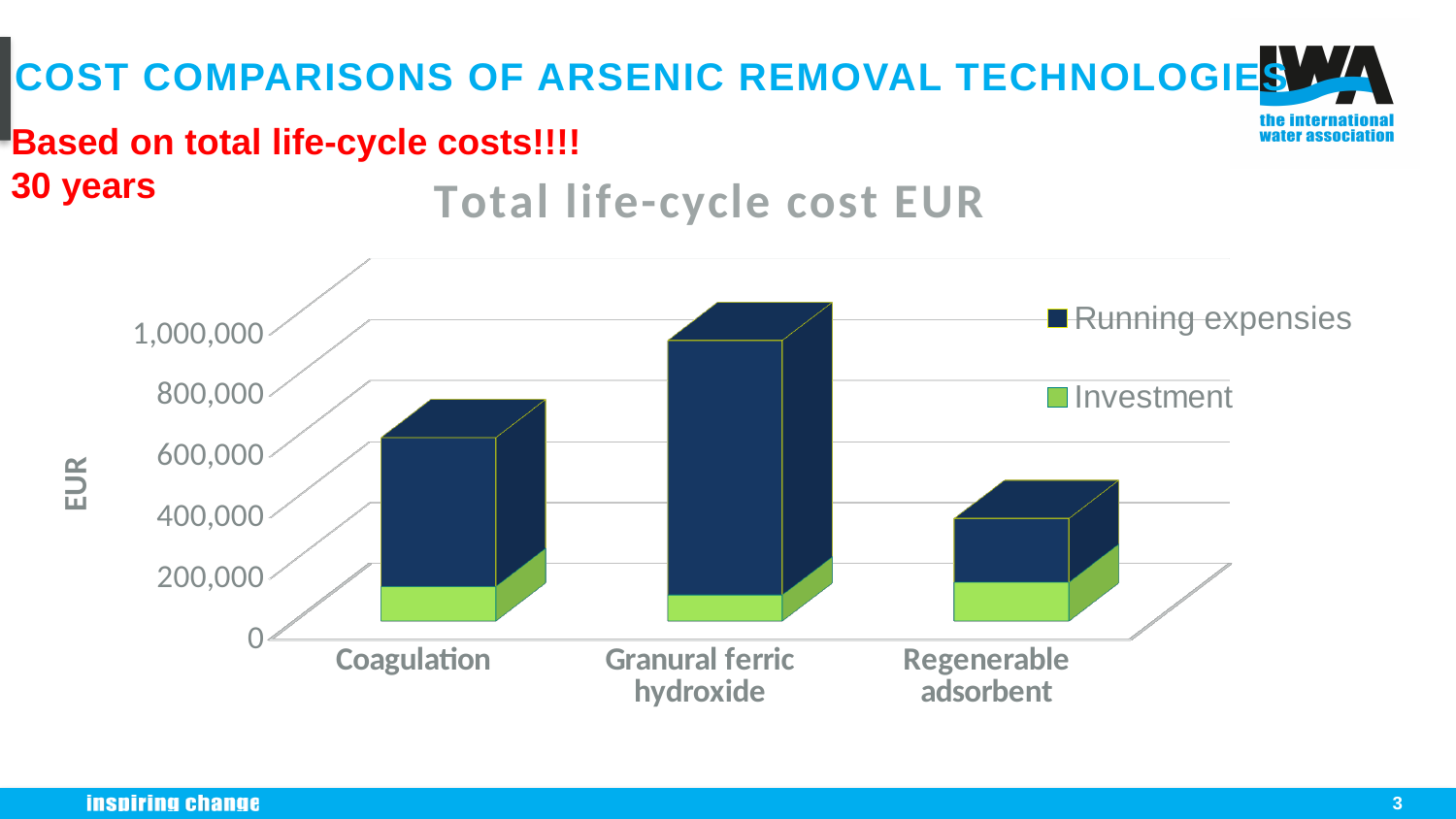
Which category has the lowest total life-cycle cost? Regenerable adsorbent Is the total value for Granural ferric hydroxide greater or less than 800,000? greater What is the title of the chart? Total life-cycle cost EUR Is the Investment value for Coagulation greater or less than 400,000? less Which series is shown in green in the chart's legend? Investment Is the total value for Regenerable adsorbent greater or less than 600,000? less How many categories are shown on the x axis of the chart? 3 How many series does the chart's legend list? 2 What kind of chart is shown on the slide? Bar chart Which category has the highest total life-cycle cost? Granural ferric hydroxide Which has a larger total life-cycle cost, Coagulation or Regenerable adsorbent? Coagulation